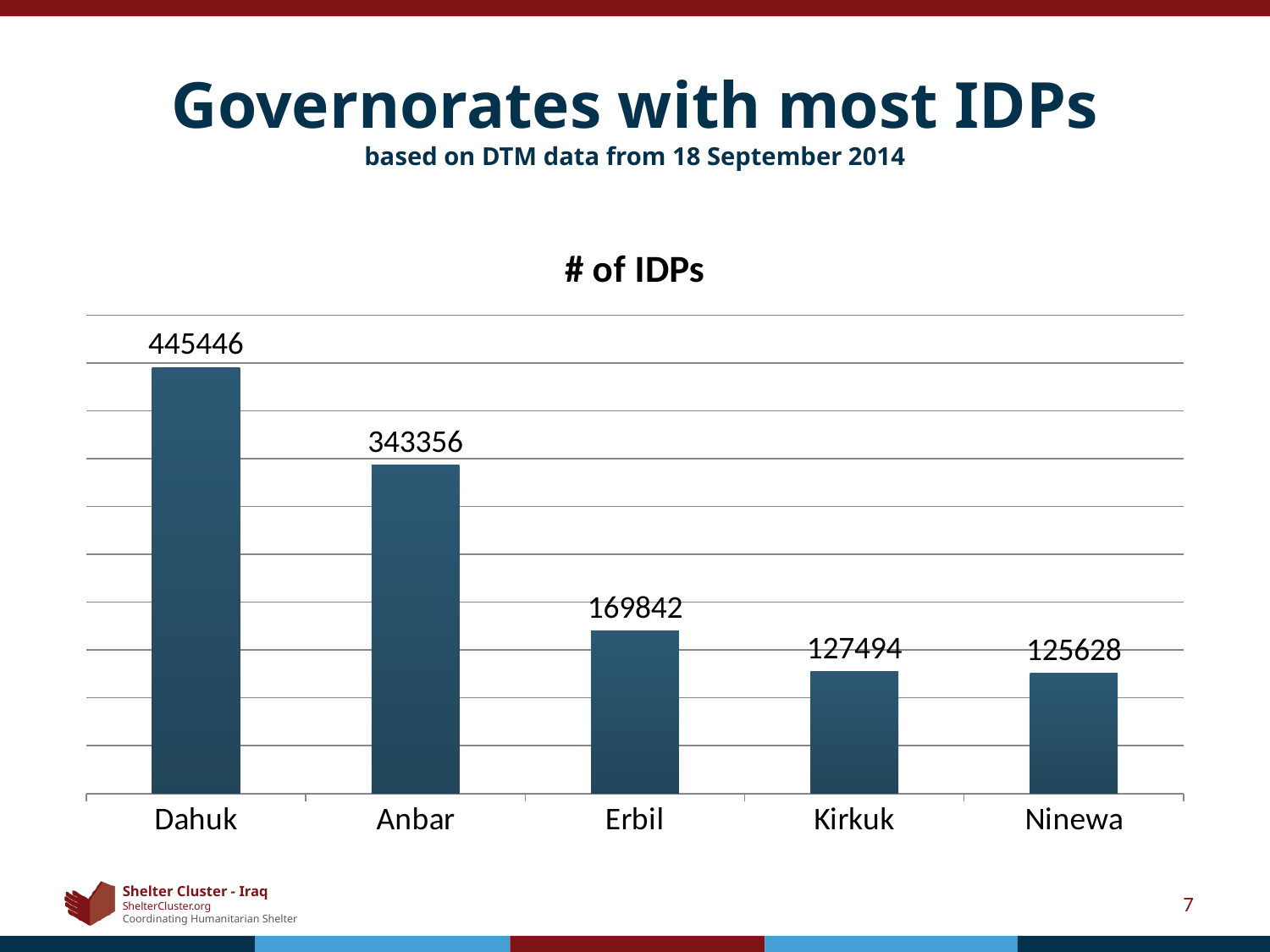
What is the number of IDPs for Dahuk? 445446 What is the number of IDPs for Anbar? 343356 What is the number of IDPs for Kirkuk? 127494 Which governorate has the lowest number of IDPs? Ninewa What is the number of IDPs for Ninewa? 125628 Which governorate has the highest number of IDPs? Dahuk What type of chart is shown on the slide? Bar chart Which has more IDPs, Anbar or Erbil? Anbar What is the number of IDPs for Erbil? 169842 What is the difference in the number of IDPs between Dahuk and Anbar? 102090 How many governorates are shown in the chart? 5 What is the difference in the number of IDPs between Kirkuk and Ninewa? 1866